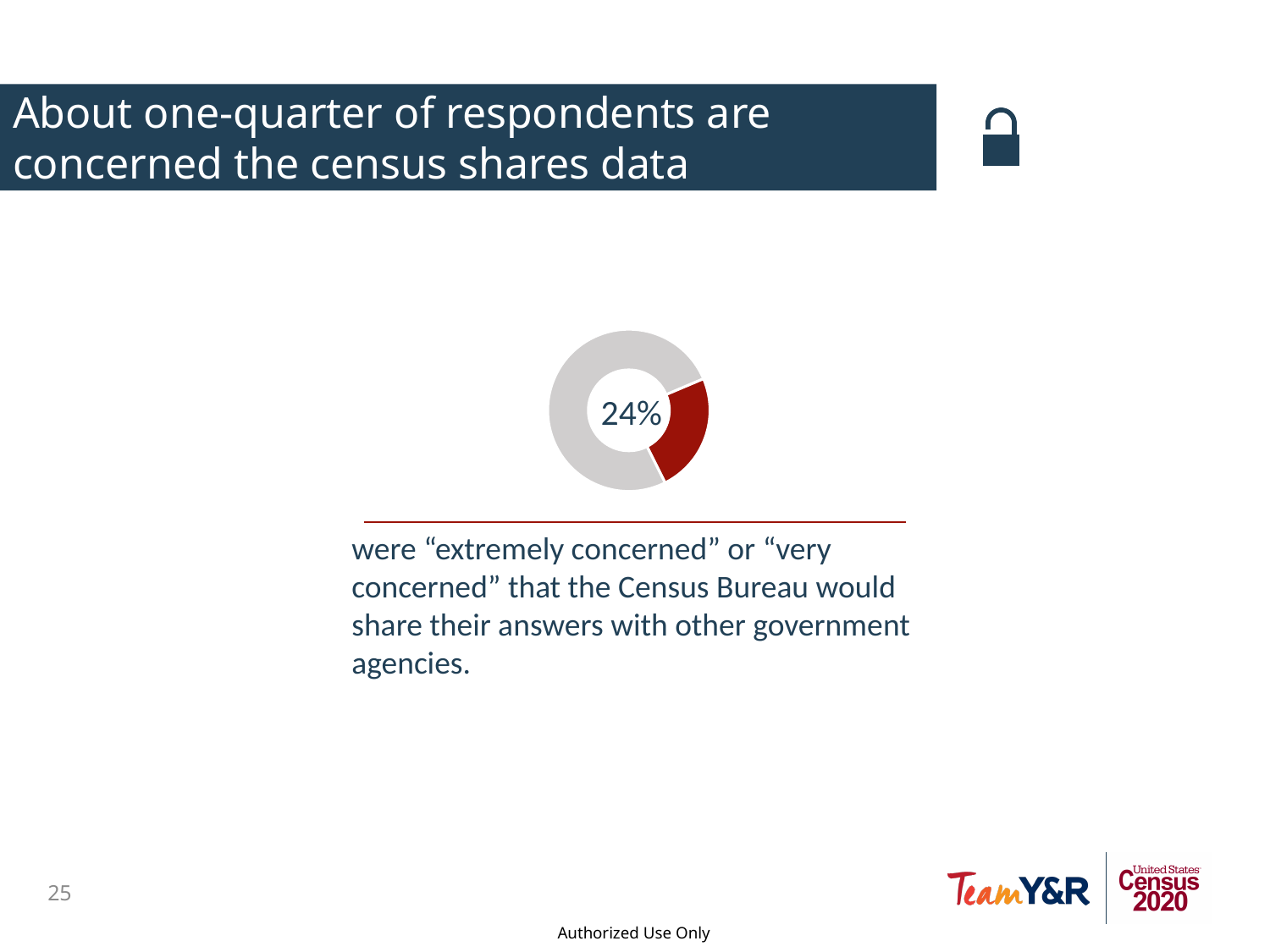
What value is printed in the centre of the donut chart? 24% Is the value shown for the red slice greater or less than 20%? greater According to the text below the chart, what does the 24% represent? Respondents who were "extremely concerned" or "very concerned" that the Census Bureau would share their answers with other government agencies What kind of chart is shown on the slide? donut (pie) chart Is the value shown for the red slice greater or less than 50%? less What is the title of the slide containing the donut chart? About one-quarter of respondents are concerned the census shares data What colour is the highlighted slice of the donut chart? red What share of the donut chart does the grey portion represent? 76% What share of the donut chart does the red slice represent? 24% How many slices does the donut chart have? 2 Which portion of the donut chart is larger, the red slice or the grey portion? the grey portion